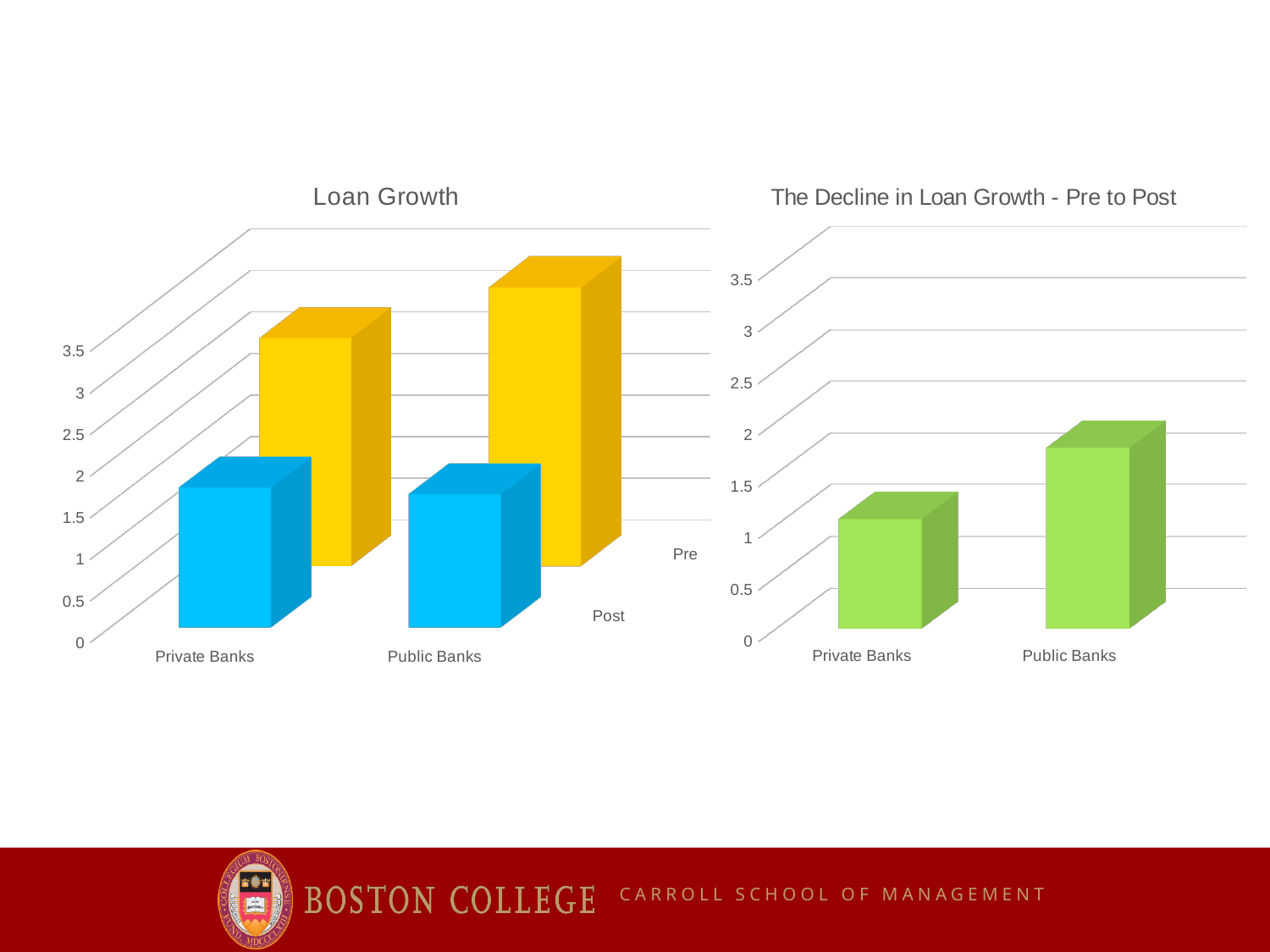
What are the two series shown in the "Loan Growth" chart? Pre and Post In the "Loan Growth" chart, is the Pre value for Public Banks greater or less than 2.5? greater What kind of chart is "The Decline in Loan Growth - Pre to Post" chart on the right? bar chart In the "Loan Growth" chart, which bar is the tallest? Pre for Public Banks What kind of chart is the "Loan Growth" chart on the left? bar chart In "The Decline in Loan Growth - Pre to Post" chart, which category has the higher value? Public Banks In the "Loan Growth" chart, is the Post value for Private Banks greater or less than 2.5? less In "The Decline in Loan Growth - Pre to Post" chart, is the value for Private Banks greater or less than 1.5? less How many series does the "Loan Growth" chart plot? 2 How many categories are shown on the x axis of the "Loan Growth" chart? 2 In the "Loan Growth" chart, which is larger for Private Banks, the Pre value or the Post value? Pre